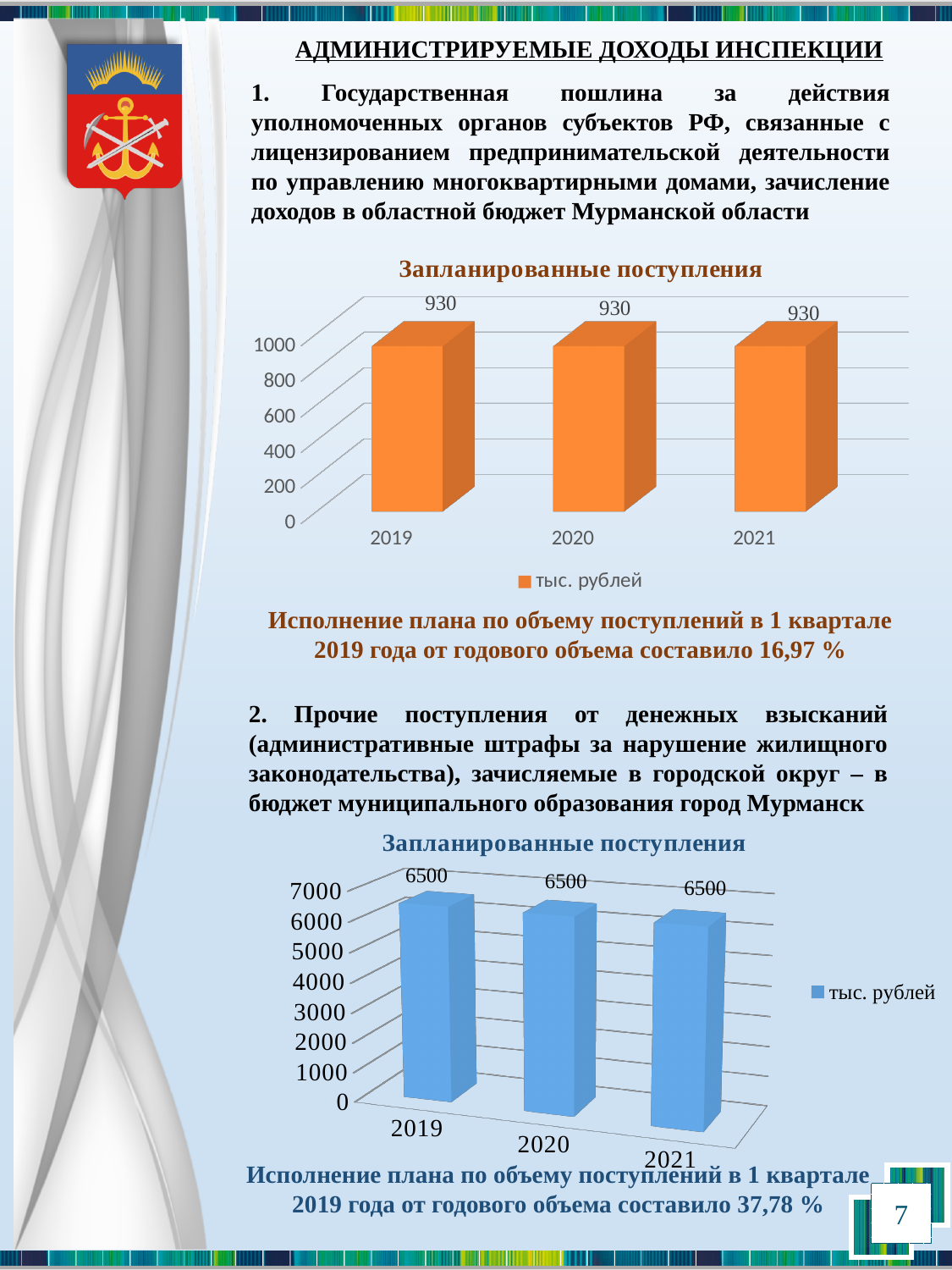
What is the legend entry of the upper chart? тыс. рублей How many categories (years) are shown in the upper chart? 3 How many series does the legend of the lower chart list? 1 In the upper chart, is the value for 2020 greater or less than 800? greater In the lower chart (blue bars), what is the value for 2021? 6500 In the upper chart, what is the difference between the values for 2020 and 2019? 0 What kind of chart is the upper chart? bar chart In the lower chart (blue bars), what is the value for 2020? 6500 In the upper chart (orange bars), what is the value for 2019? 930 In the lower chart, do the values rise, fall, or stay the same from 2019 to 2021? stay the same In the upper chart (orange bars), what is the value for 2021? 930 What is the title of the lower chart? Запланированные поступления